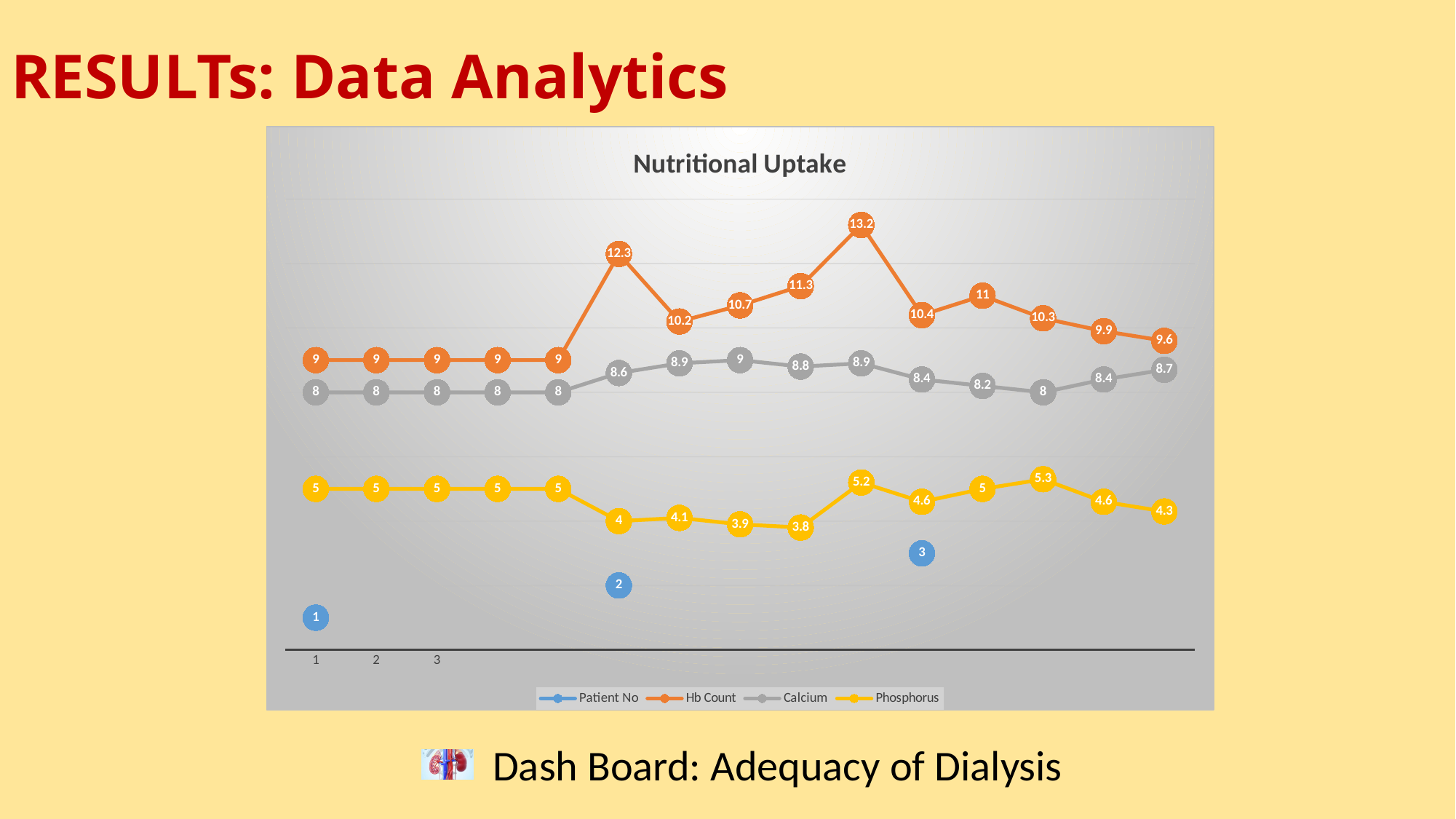
Which series has the higher peak value, Hb Count or Calcium? Hb Count How many series does the legend of the 'Nutritional Uptake' chart list? 4 What is the highest value plotted for the Calcium series? 9 What is the highest value plotted for the Hb Count series? 13.2 What is the difference between the highest Hb Count value (13.2) and the lowest Hb Count value (9)? 4.2 What kind of chart is shown under the title 'Nutritional Uptake'? line chart How many data points are plotted for the Hb Count series? 15 What is the Hb Count value at x-axis position 1? 9 What is the title of the chart on the slide? Nutritional Uptake What is the Calcium value at x-axis position 2? 8 What is the lowest value plotted for the Phosphorus series? 3.8 What is the Phosphorus value at x-axis position 3? 5